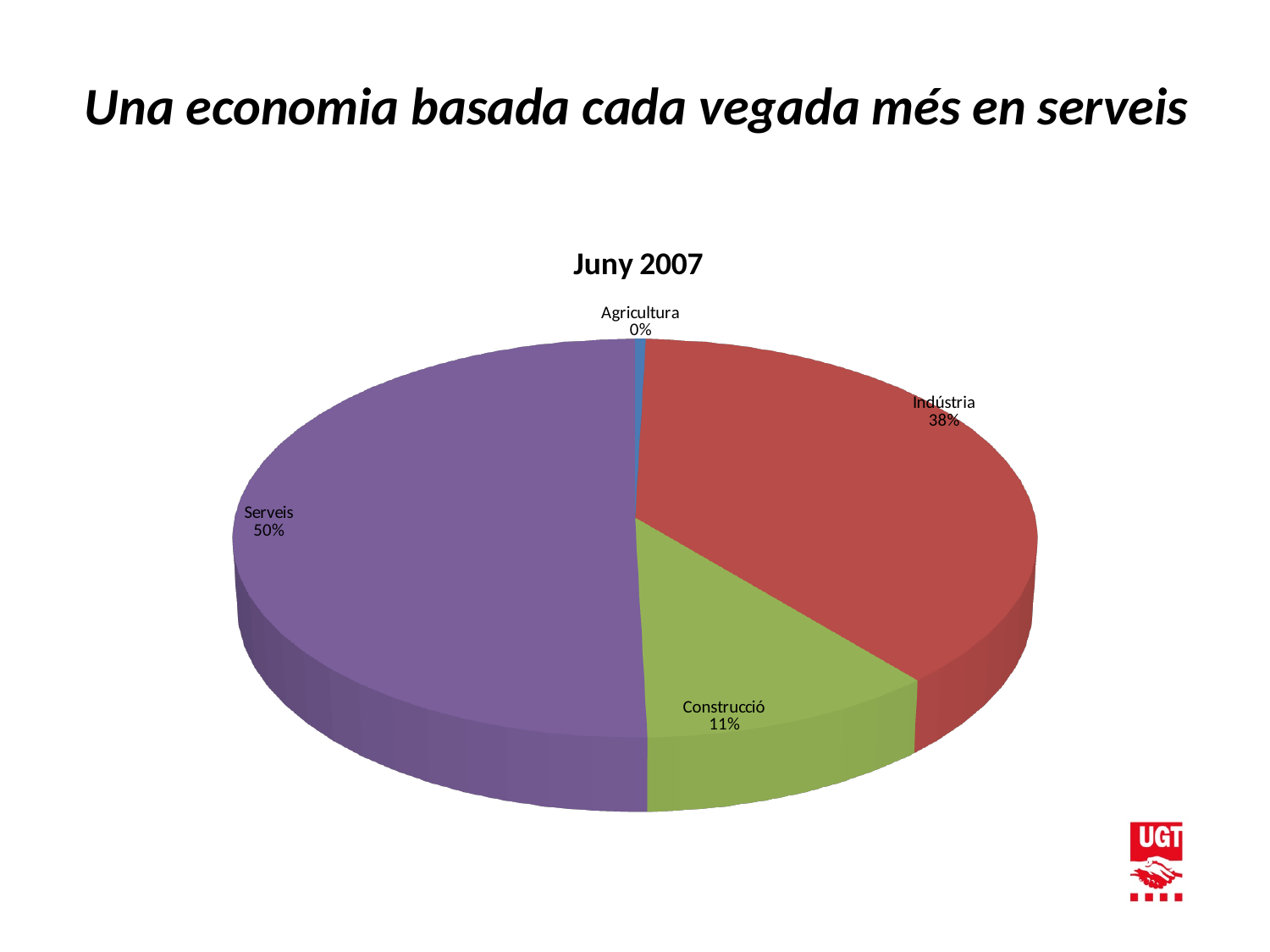
What share of the pie does Construcció have? 11% What colour is the Serveis slice? purple What share of the pie does Agricultura have? 0% What kind of chart is shown on the slide? pie chart What is the difference in percentage points between Serveis and Indústria? 12 Which category has the smallest slice of the pie? Agricultura What is the title of the chart? Juny 2007 How many categories are shown in the pie chart? 4 Which is larger, Indústria or Construcció? Indústria What share of the pie does Serveis have? 50% Which category has the largest slice of the pie? Serveis